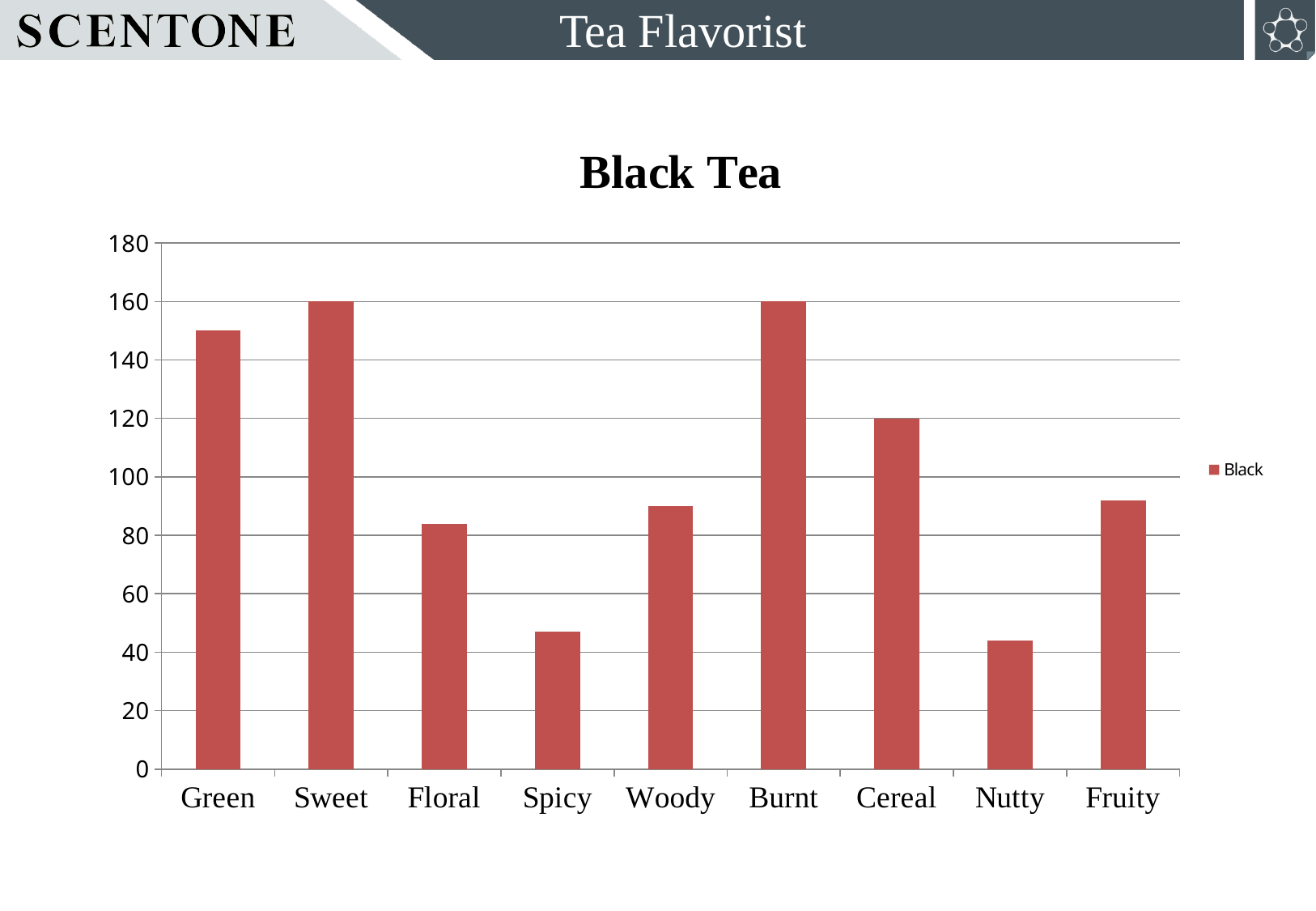
What is the value for Cereal? 120 How many series does the legend list? 1 Which is larger, the value for Cereal or the value for Woody? Cereal What is the difference between the values for Sweet and Cereal? 40 How many categories are shown on the x axis of the chart? 9 Is the value for Spicy greater or less than 60? less What is the value for Sweet? 160 What is the title of the chart? Black Tea Is the value for Green greater or less than 140? greater Which is larger, the value for Green or the value for Floral? Green What type of chart is shown on the slide? bar chart What is the value for Burnt? 160